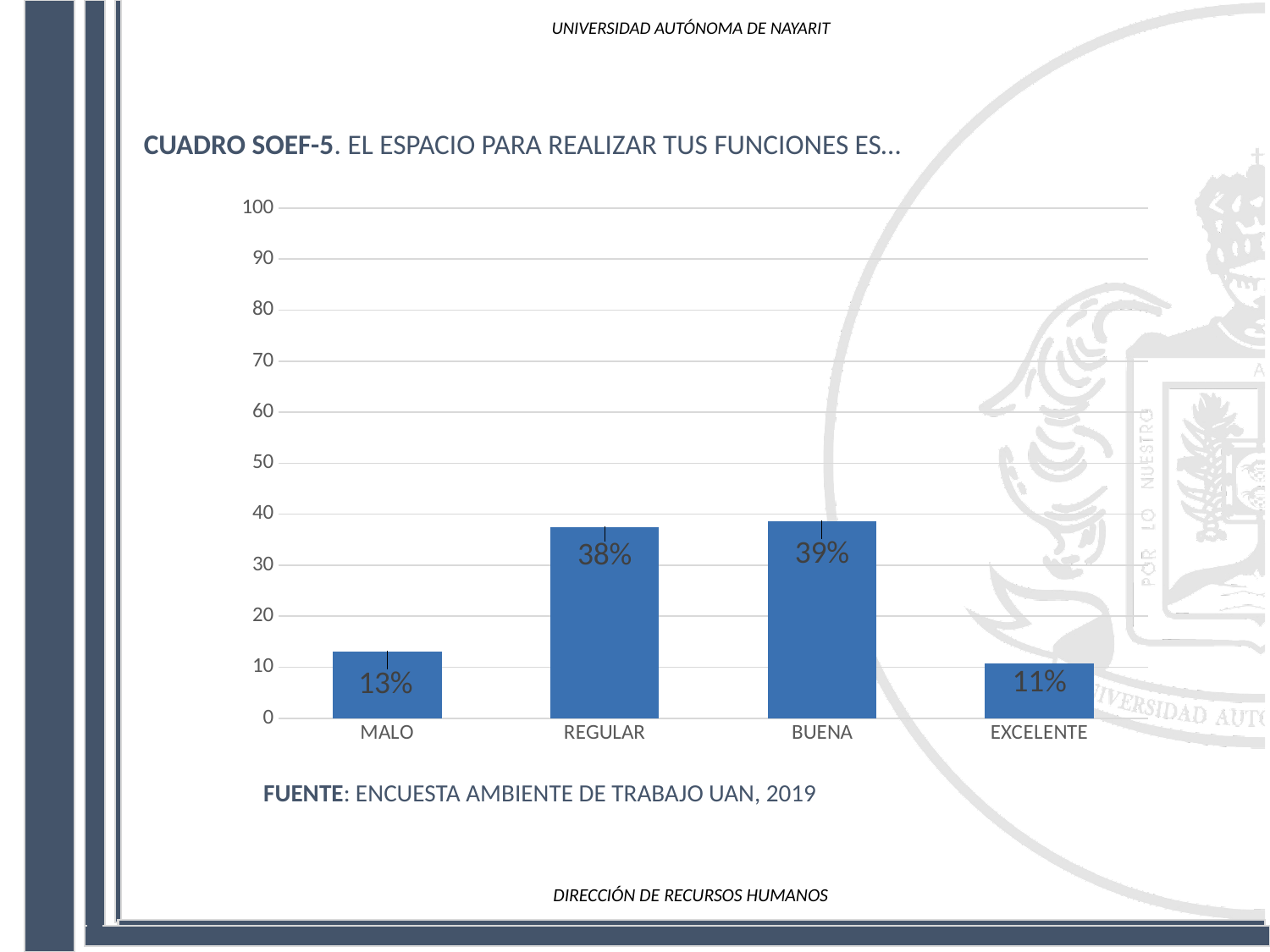
What is the value for BUENA? 39% Which category has the highest value? BUENA How many categories are shown on the x axis? 4 What is the difference between the values for REGULAR and MALO? 25% Which is larger, the value for MALO or the value for EXCELENTE? MALO What is the value for REGULAR? 38% Which category has the lowest value? EXCELENTE What is the value for MALO? 13% What kind of chart is shown on the slide? bar chart Is the value for BUENA greater or less than 30? greater What source is cited below the chart? ENCUESTA AMBIENTE DE TRABAJO UAN, 2019 What is the value for EXCELENTE? 11%